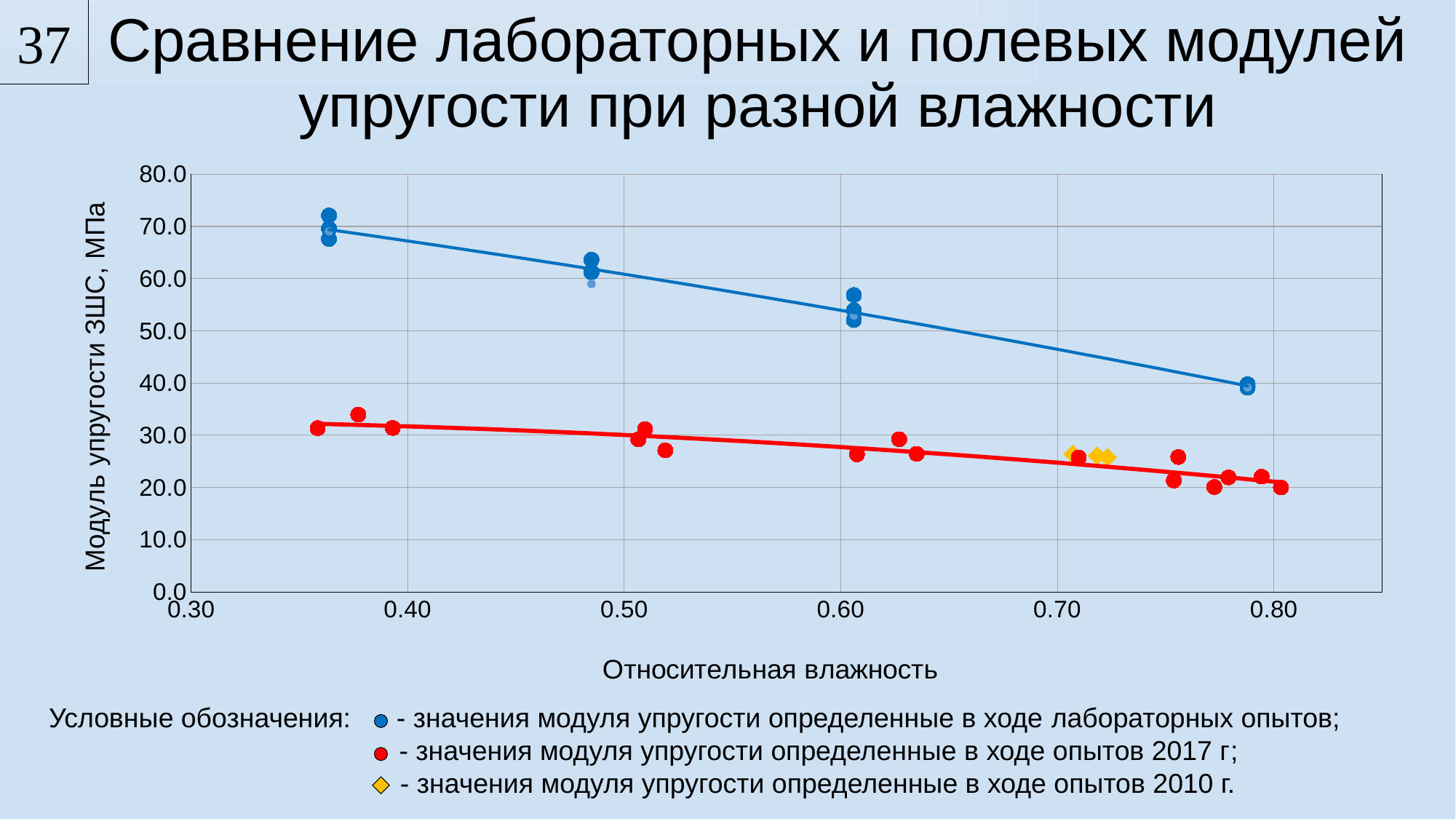
What is the label of the vertical axis? Модуль упругости ЗШС, МПа Is the laboratory (blue) value at a relative humidity of about 0.79 greater or less than 50.0 MPa? less Do the laboratory (blue) values of the elastic modulus rise or fall as relative humidity increases? fall Do the 2017 field (red) values of the elastic modulus rise or fall as relative humidity increases? fall What marker shape and colour represent the values determined in the 2010 experiments? yellow diamonds Are the laboratory (blue) values at a relative humidity of about 0.36 greater or less than 60.0 MPa? greater At a relative humidity of about 0.60, which series has the larger elastic modulus: the laboratory (blue) or the 2017 field (red) series? laboratory (blue) Are the 2017 field (red) values at a relative humidity of about 0.80 greater or less than 30.0 MPa? less Which series has the highest elastic modulus values overall? laboratory values (blue) How many series does the legend list? 3 What kind of chart is shown on the slide? scatter chart